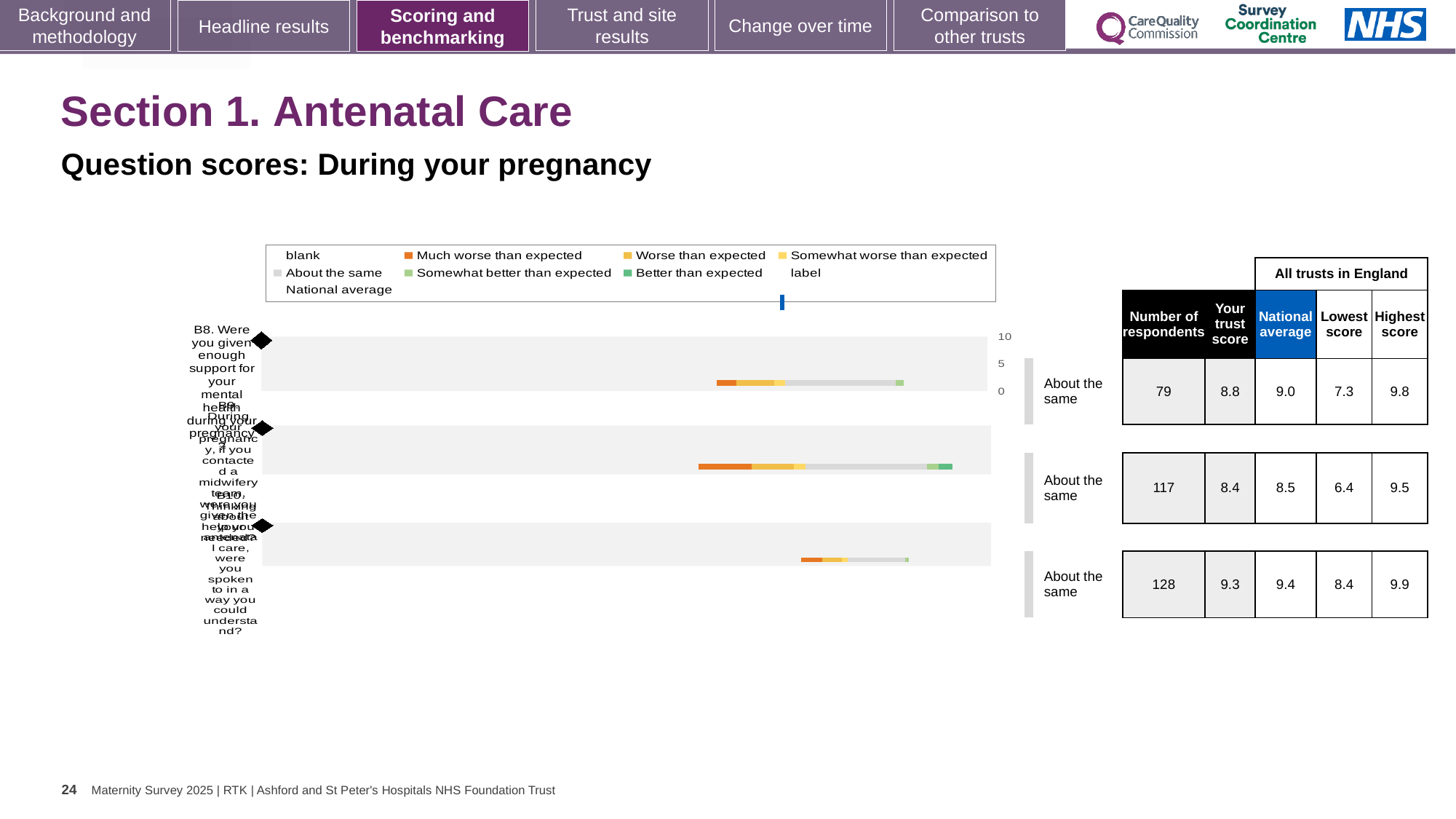
What is the highest score among all trusts in England for the second row of the chart? 9.5 What is the number of respondents for question B8 (support for your mental health during your pregnancy)? 79 What is the trust score for question B8 (support for your mental health during your pregnancy)? 8.8 For the second row of the chart, which is larger: the trust score or the national average? the national average (8.5) How many survey questions (rows) are plotted in the chart? 3 Which row of the chart has the lowest number of respondents? B8 (79) What benchmark category is shown for all three rows of the chart? About the same What is the difference between the national average and the trust score for question B8? 0.2 What is the national average for question B8 (support for your mental health during your pregnancy)? 9.0 What kind of chart is shown on the slide? bar chart Which row of the chart has the highest trust score? the third row (9.3) What is the lowest score among all trusts in England for the third row of the chart? 8.4